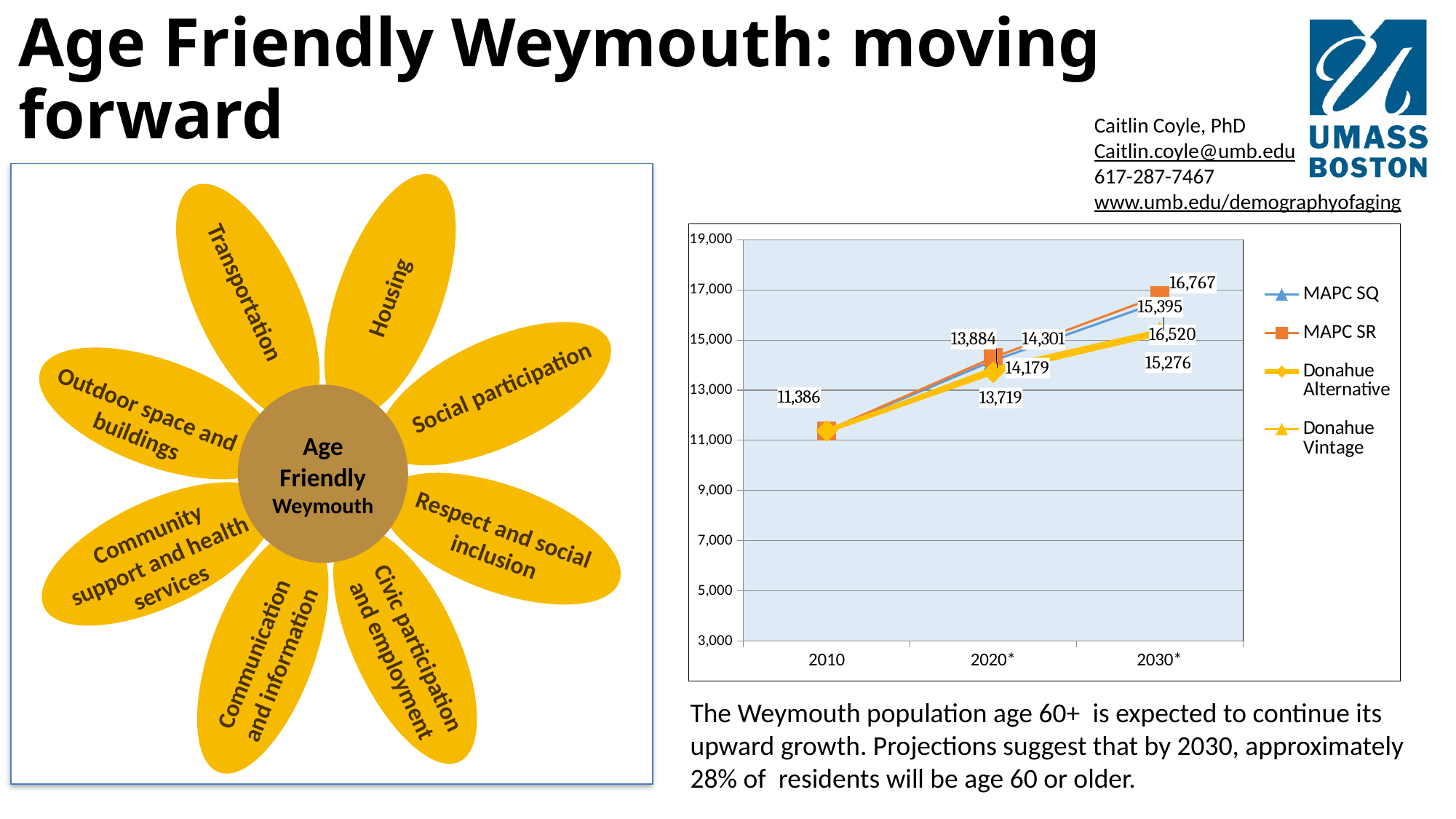
What kind of chart is shown on the right side of the slide? line chart How many years are shown on the x axis of the line chart? 3 Is the value for 2010 in the line chart greater or less than 11,000? greater What is the lowest value labeled for 2020* in the line chart? 13,719 Which series in the line chart is drawn with square markers? MAPC SR What is the value shown for 2010 in the line chart? 11,386 Do the values in the line chart rise or fall from 2010 to 2030*? rise What is the value for MAPC SR in 2030* in the line chart? 16,767 What is the highest value labeled for 2030* in the line chart? 16,767 What is the difference between the MAPC SR value in 2030* (16,767) and the 2010 value (11,386)? 5,381 Which series is listed first in the legend of the line chart? MAPC SQ How many series does the legend of the line chart list? 4